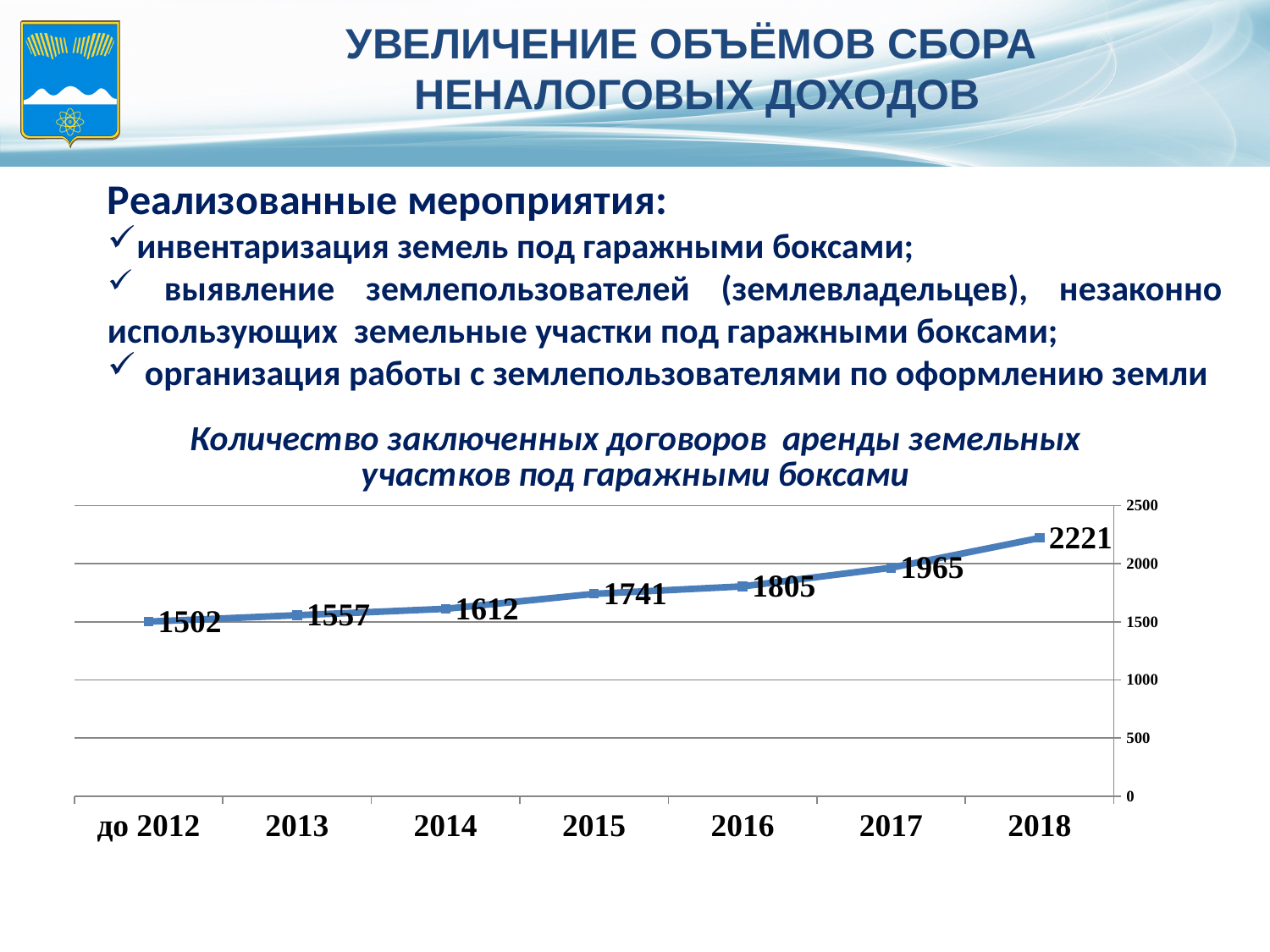
What is the value for 2018 in the chart? 2221 What kind of chart is shown on the slide? line chart How many data points are plotted in the chart? 7 Is the value for 2017 greater or less than 2000? less Which is larger, the value for 2016 or the value for 2015? 2016 What is the value for 'до 2012' in the chart? 1502 What is the value for 2015 in the chart? 1741 What is the difference between the values for 2014 and 2013? 55 Do the values rise or fall from 'до 2012' to 2018? rise Which category has the lowest value in the chart? до 2012 What is the difference between the values for 2018 and 2017? 256 Which year has the highest value in the chart? 2018